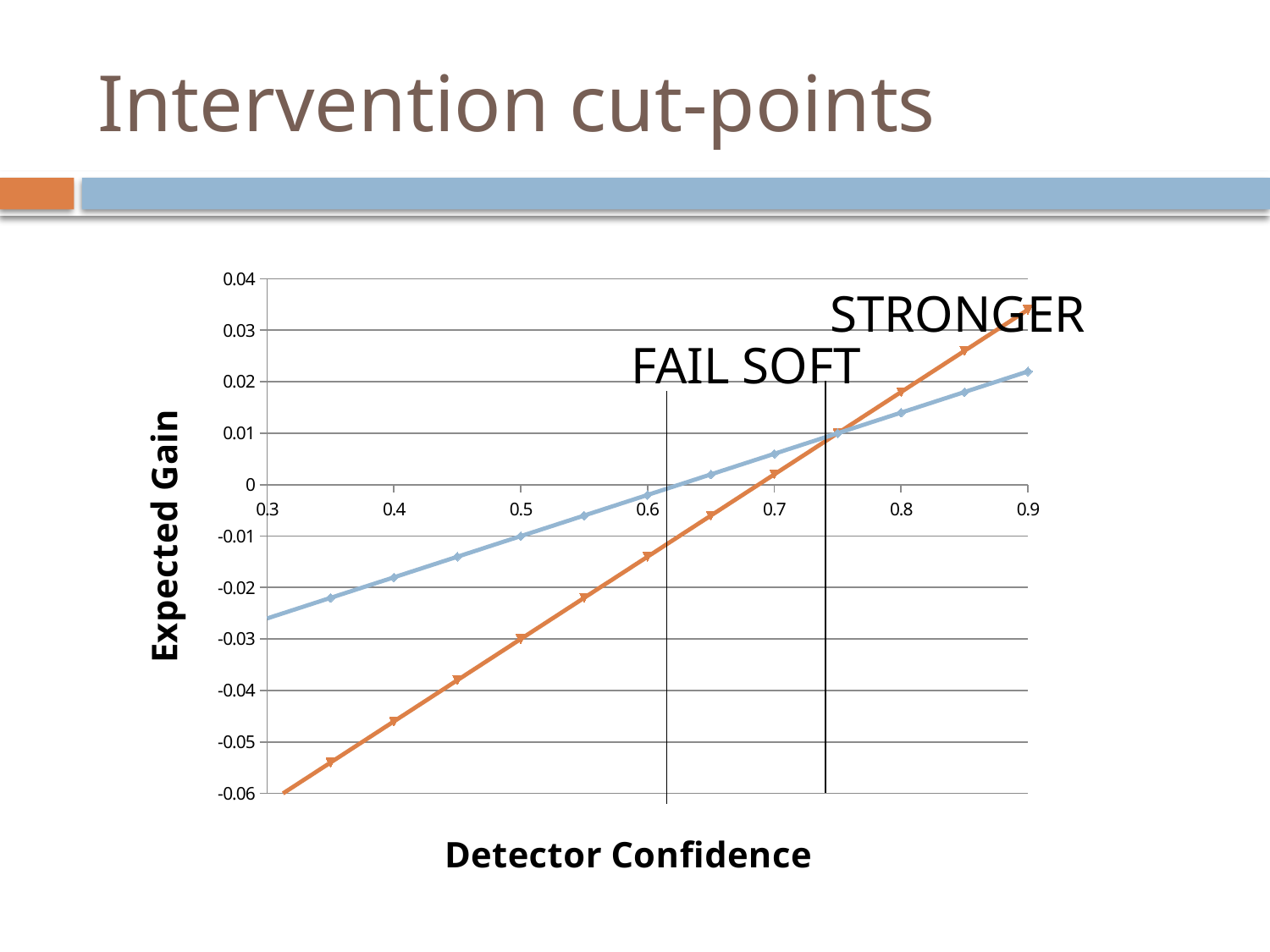
What is the Expected Gain of the orange line at a Detector Confidence of 0.5? -0.03 What is the title of the y axis? Expected Gain Is the Expected Gain of the blue line at a Detector Confidence of 0.3 greater or less than -0.02? less What is the Expected Gain of the blue line at a Detector Confidence of 0.5? -0.01 What kind of chart is shown on the slide? line chart How many lines (data series) are plotted on the chart? 2 Do the values of the blue line rise or fall as Detector Confidence increases? rise At a Detector Confidence of 0.4, which line has the higher Expected Gain, the blue line or the orange line? the blue line Do the values of the orange line rise or fall as Detector Confidence increases? rise Is the Expected Gain of the orange line at a Detector Confidence of 0.9 greater or less than 0.03? greater What is the title of the x axis? Detector Confidence